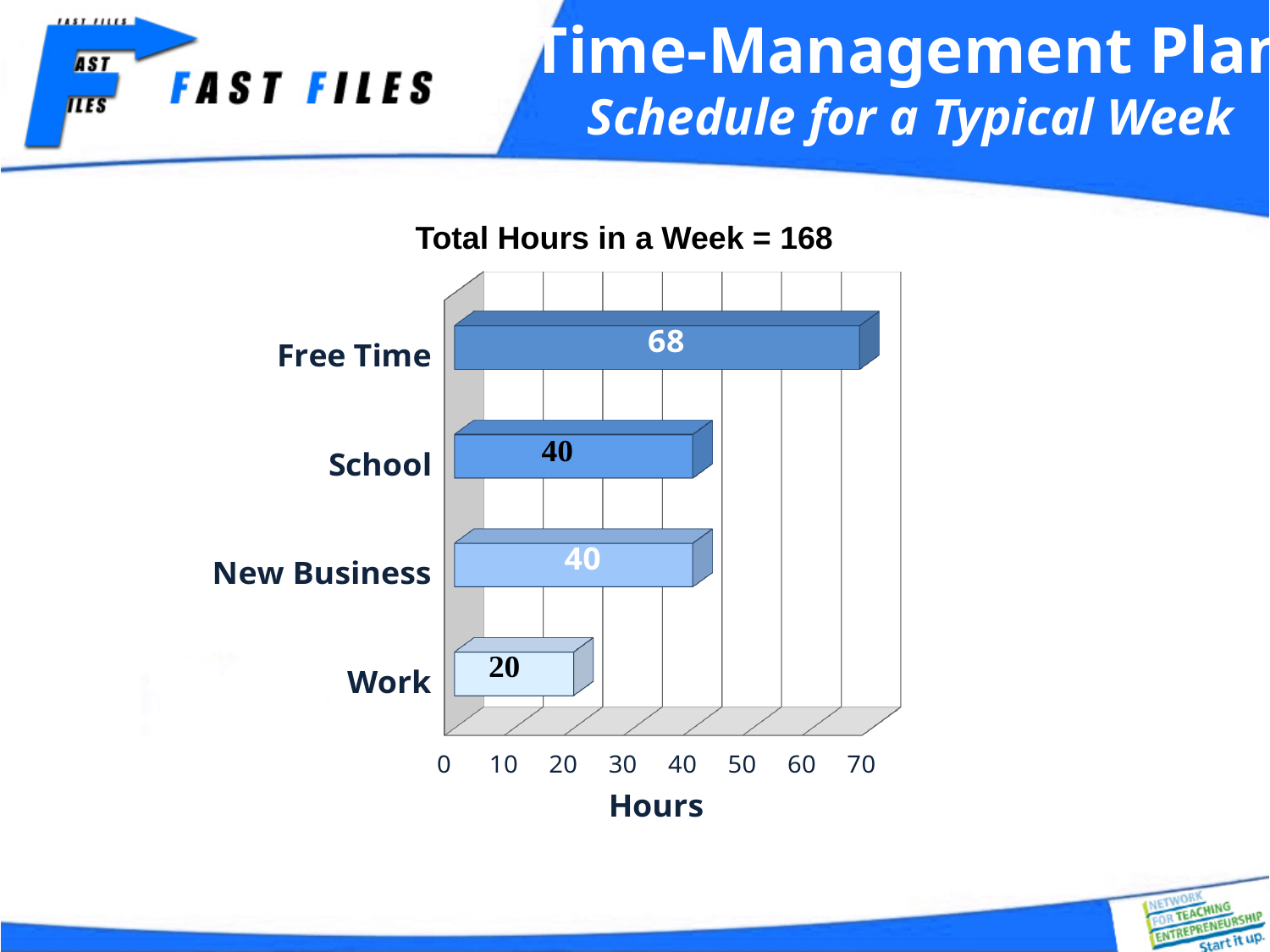
How many hours are shown for School? 40 How many hours are shown for Free Time? 68 Which has more hours, Free Time or School? Free Time Which category has the lowest number of hours? Work Which category has the highest number of hours? Free Time What kind of chart is shown on the slide? Bar chart What is the title of the chart? Total Hours in a Week = 168 What is the difference in hours between School and Work? 20 How many hours are shown for New Business? 40 How many categories are shown in the chart? 4 What is the difference in hours between Free Time and Work? 48 How many hours are shown for Work? 20